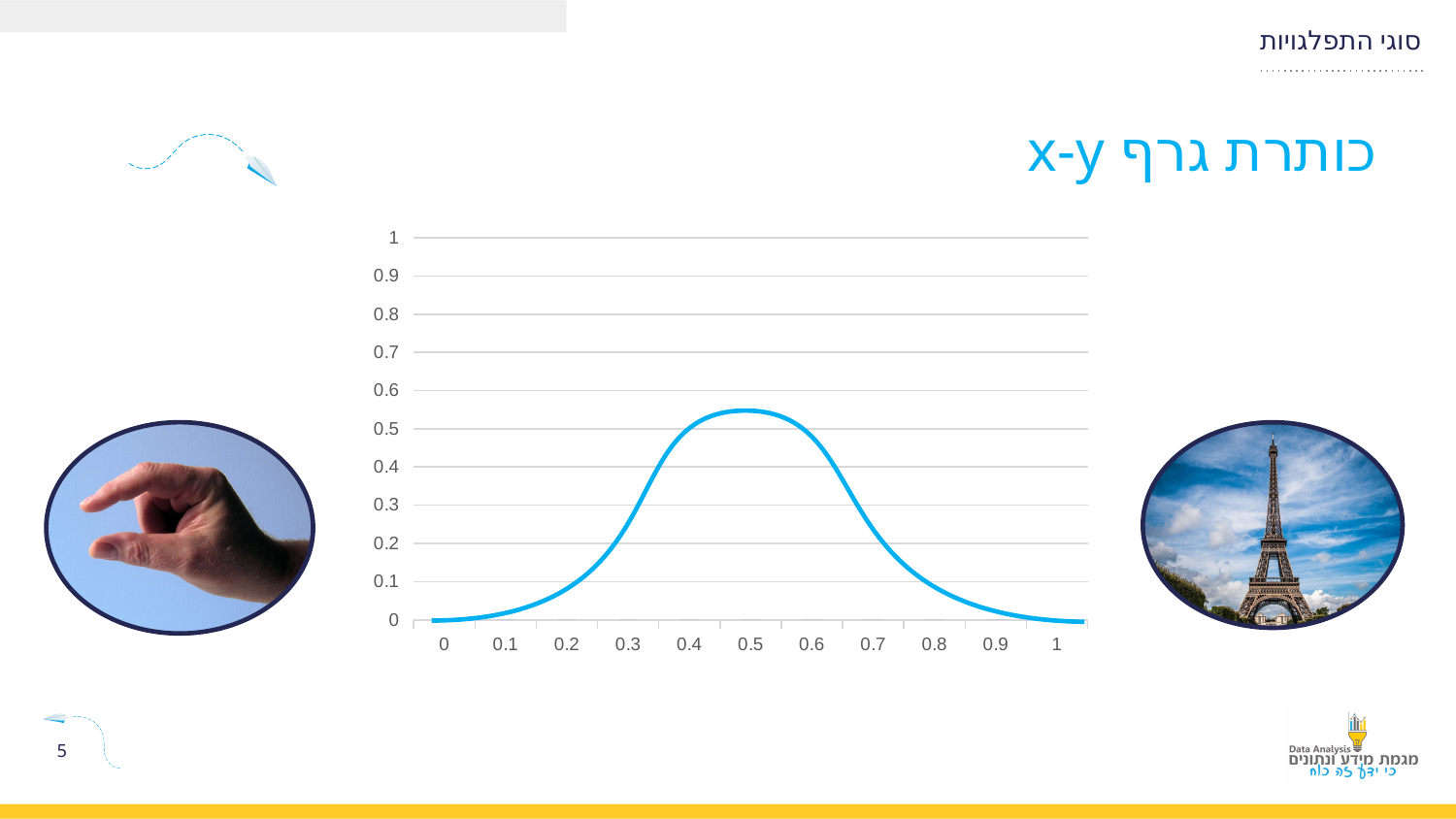
At which x value does the curve reach its highest point? 0.5 Which is larger: the value of the curve at x = 0.4 or at x = 0.9? x = 0.4 Is the value of the curve at x = 0.8 greater or less than 0.2? less How many tick labels are shown on the x axis? 11 Does the curve rise or fall as x goes from 0.5 to 1? fall Is the value of the curve at x = 0.2 greater or less than 0.2? less What kind of chart is shown on the slide? line chart Is the value of the curve at x = 0.5 greater or less than 0.4? greater What colour is the plotted line? blue What is the title of the chart? כותרת גרף x-y Does the curve rise or fall as x goes from 0 to 0.5? rise